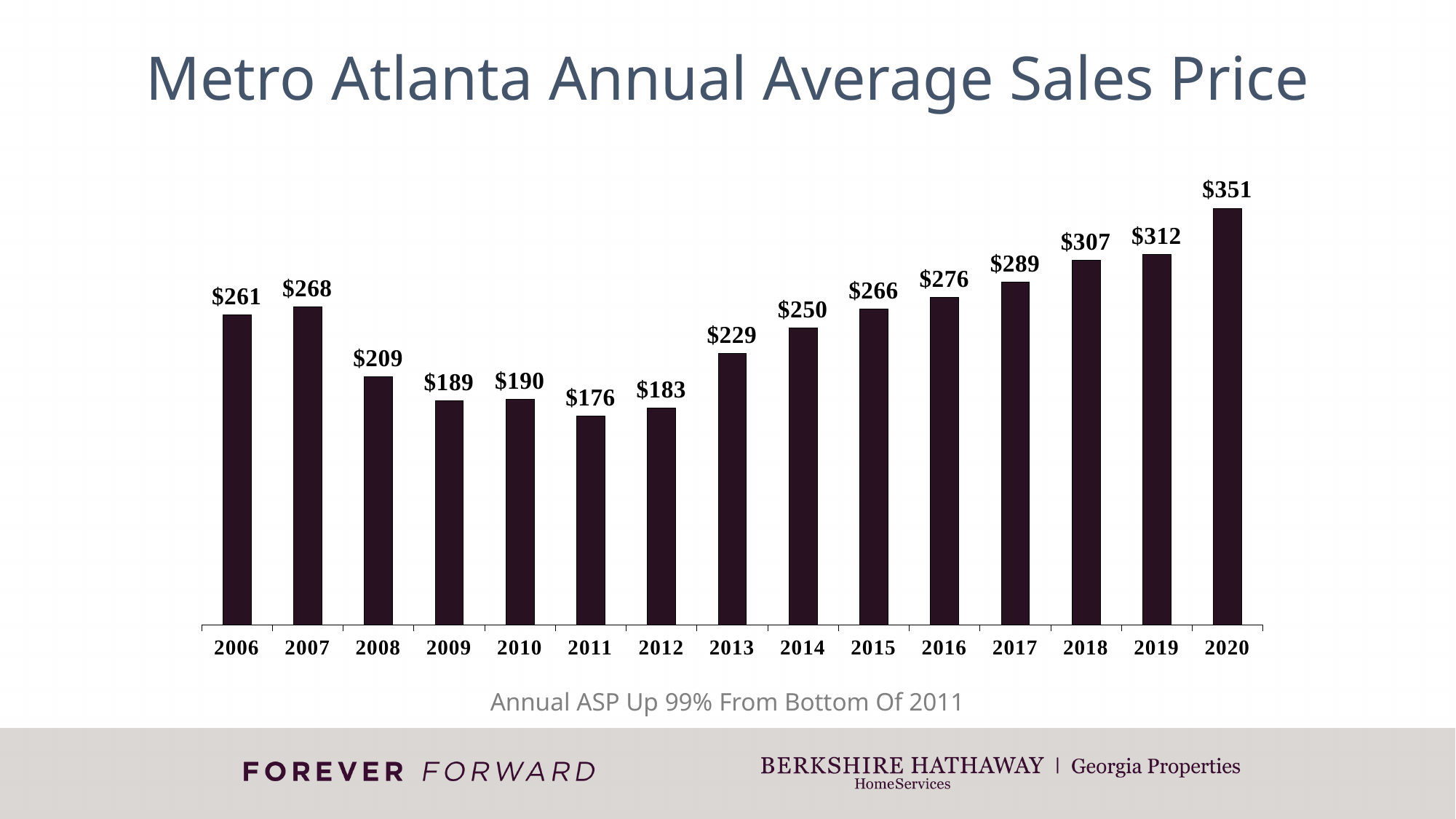
Do the average sales prices rise or fall from 2011 to 2020? Rise What is the difference between the 2007 and 2008 average sales prices? $59 Which year has a higher average sales price, 2006 or 2015? 2015 What kind of chart is shown on the slide? Bar chart Which year has the highest average sales price? 2020 What is the difference between the 2020 and 2011 average sales prices? $175 How many years are shown on the chart? 15 What is the title of the chart? Metro Atlanta Annual Average Sales Price What is the average sales price shown for 2014? $250 What is the average sales price shown for 2011? $176 Which year has the lowest average sales price? 2011 What is the average sales price shown for 2020? $351